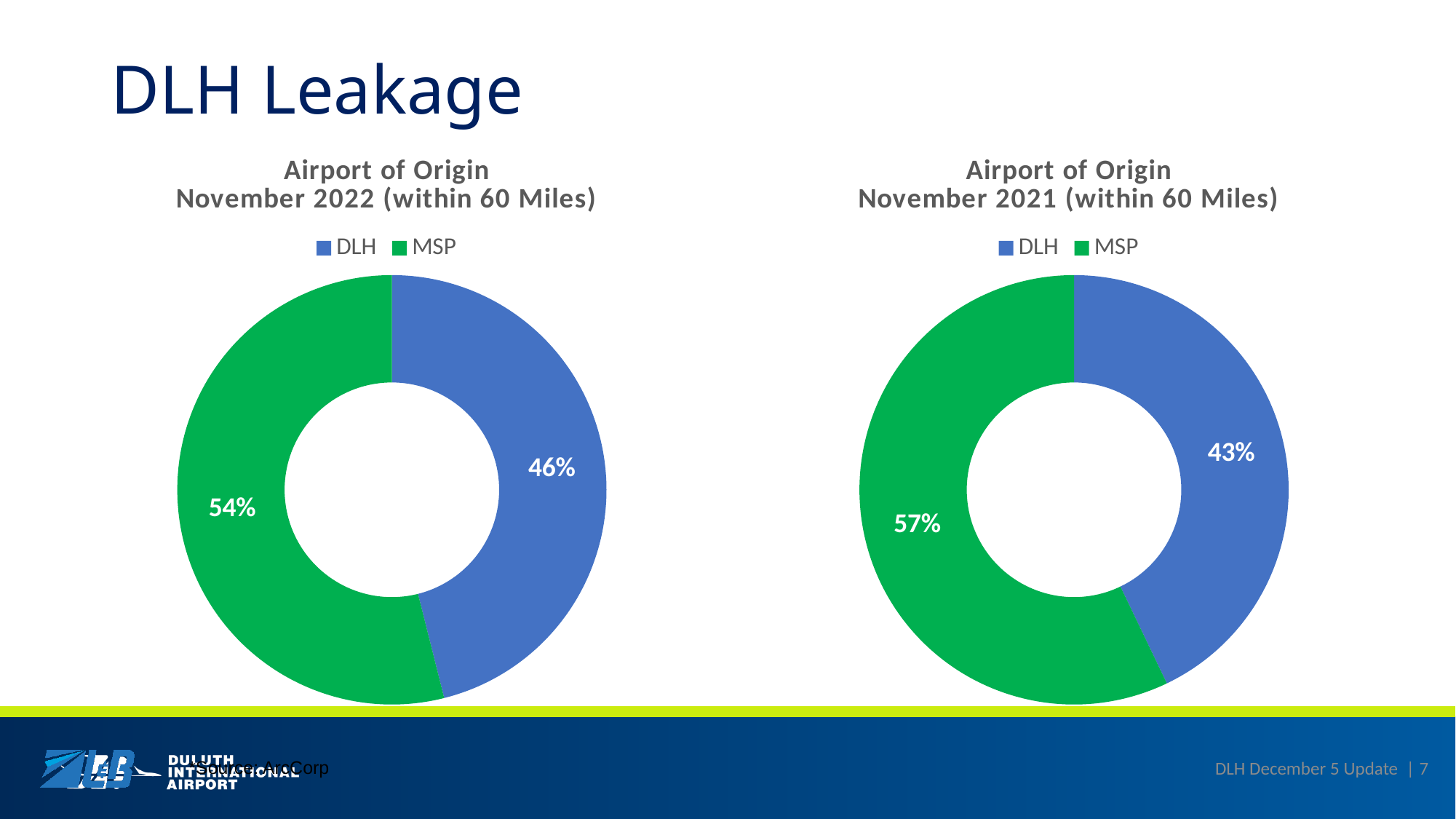
Is the DLH share larger in the November 2022 chart or the November 2021 chart? November 2022 In the November 2021 chart, which airport has the smaller share? DLH How many categories does the November 2022 chart show? 2 In the November 2022 chart, which colour represents MSP? Green In the November 2022 chart, what share of the airport of origin is MSP? 54% In the November 2022 chart, what is the difference between the MSP and DLH shares? 8% In the November 2022 chart, what share of the airport of origin is DLH? 46% What kind of chart is the November 2021 chart? Doughnut (pie) chart In the November 2021 chart, what is the difference between the MSP and DLH shares? 14% In the November 2022 chart, which airport has the larger share? MSP In the November 2021 chart, what share of the airport of origin is DLH? 43% In the November 2021 chart, what share of the airport of origin is MSP? 57%